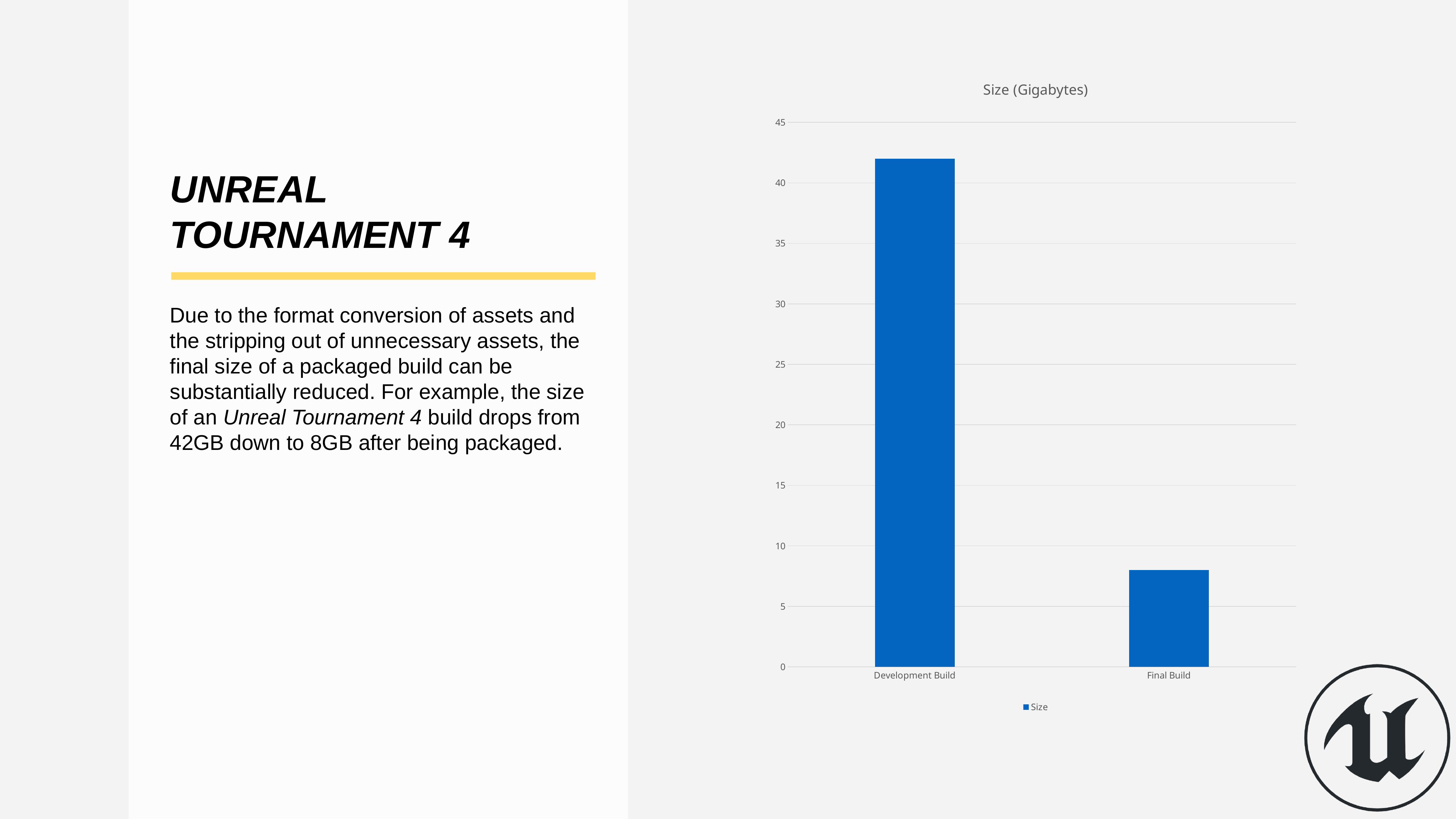
Is the value for Final Build greater or less than 10? less Which category has the highest value in the chart? Development Build How many series does the chart legend list? 1 What type of chart is shown on the slide? bar chart How many categories are plotted on the x axis of the chart? 2 What is the title of the chart? Size (Gigabytes) What is the name of the series shown in the chart legend? Size Is the value for Development Build greater or less than 40? greater Do the values rise or fall from Development Build to Final Build along the x axis? fall Which is larger, the value for Development Build or the value for Final Build? Development Build Which category has the lowest value in the chart? Final Build Is the value for Development Build greater or less than 45? less